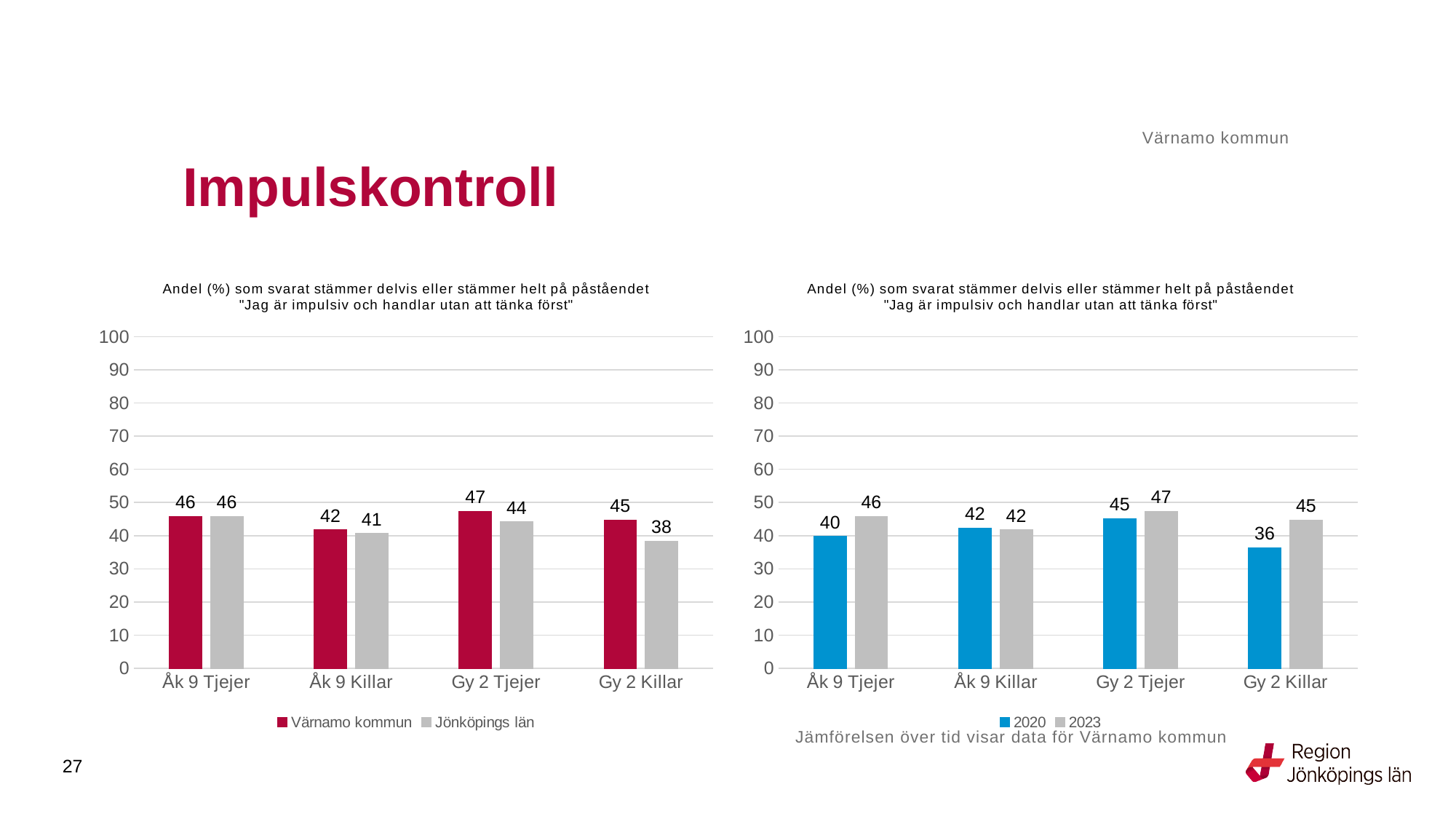
In the right chart, what is the value for 2020 for Gy 2 Killar? 36 In the right chart, what is the value for 2023 for Åk 9 Tjejer? 46 How many series does the legend of the right chart list? 2 In the left chart, what is the value for Värnamo kommun for Gy 2 Killar? 45 In the right chart, which category has the lowest value for 2020? Gy 2 Killar In the left chart, what is the value for Jönköpings län for Gy 2 Killar? 38 In the right chart, which is larger for Åk 9 Tjejer: 2020 or 2023? 2023 In the left chart, which category has the highest value for Värnamo kommun? Gy 2 Tjejer How many categories are shown on the x axis of the left chart? 4 In the right chart, what is the difference between 2023 and 2020 for Gy 2 Killar? 9 What kind of chart is the left chart? Bar chart In the left chart, what is the difference between Värnamo kommun and Jönköpings län for Gy 2 Killar? 7